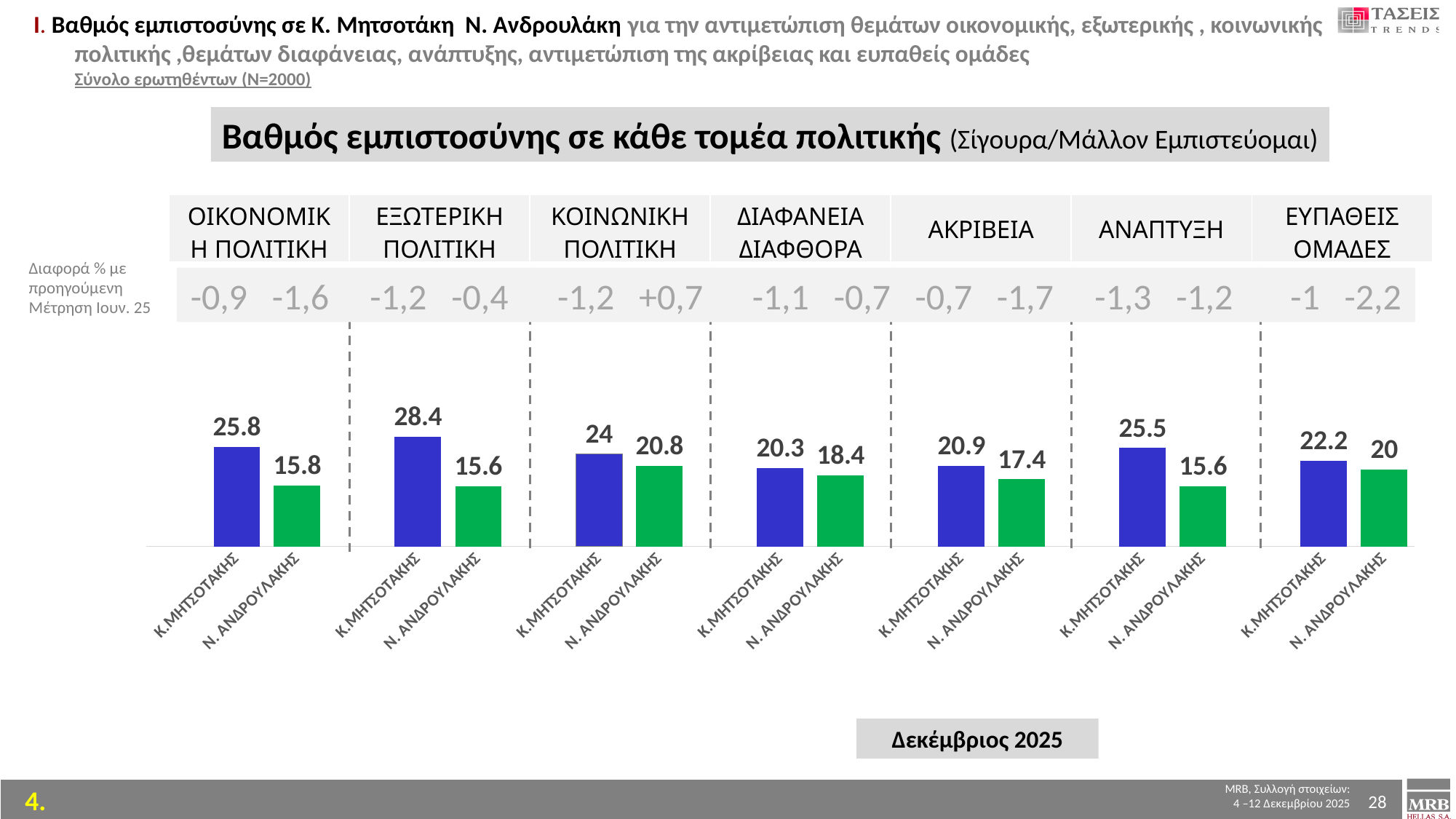
What is the difference between Κ. ΜΗΤΣΟΤΑΚΗΣ and Ν. ΑΝΔΡΟΥΛΑΚΗΣ in the ΟΙΚΟΝΟΜΙΚΗ ΠΟΛΙΤΙΚΗ section? 10 What is the value for Κ. ΜΗΤΣΟΤΑΚΗΣ in the ΕΞΩΤΕΡΙΚΗ ΠΟΛΙΤΙΚΗ section? 28.4 What is the value for Ν. ΑΝΔΡΟΥΛΑΚΗΣ in the ΕΥΠΑΘΕΙΣ ΟΜΑΔΕΣ section? 20 In the ΑΚΡΙΒΕΙΑ section, who has the larger value, Κ. ΜΗΤΣΟΤΑΚΗΣ or Ν. ΑΝΔΡΟΥΛΑΚΗΣ? Κ. ΜΗΤΣΟΤΑΚΗΣ What kind of chart is shown on the slide? Bar chart What is the change from the previous measurement (Ιουν. 25) shown for Ν. ΑΝΔΡΟΥΛΑΚΗΣ in the ΚΟΙΝΩΝΙΚΗ ΠΟΛΙΤΙΚΗ section? +0,7 What is the value for Ν. ΑΝΔΡΟΥΛΑΚΗΣ in the ΚΟΙΝΩΝΙΚΗ ΠΟΛΙΤΙΚΗ section? 20.8 In which policy area does Κ. ΜΗΤΣΟΤΑΚΗΣ have the highest value? ΕΞΩΤΕΡΙΚΗ ΠΟΛΙΤΙΚΗ What is the difference between Κ. ΜΗΤΣΟΤΑΚΗΣ and Ν. ΑΝΔΡΟΥΛΑΚΗΣ in the ΑΝΑΠΤΥΞΗ section? 9.9 How many policy areas are shown in the chart? 7 In which policy area does Ν. ΑΝΔΡΟΥΛΑΚΗΣ have the highest value? ΚΟΙΝΩΝΙΚΗ ΠΟΛΙΤΙΚΗ In which policy area does Κ. ΜΗΤΣΟΤΑΚΗΣ have the lowest value? ΔΙΑΦΑΝΕΙΑ ΔΙΑΦΘΟΡΑ